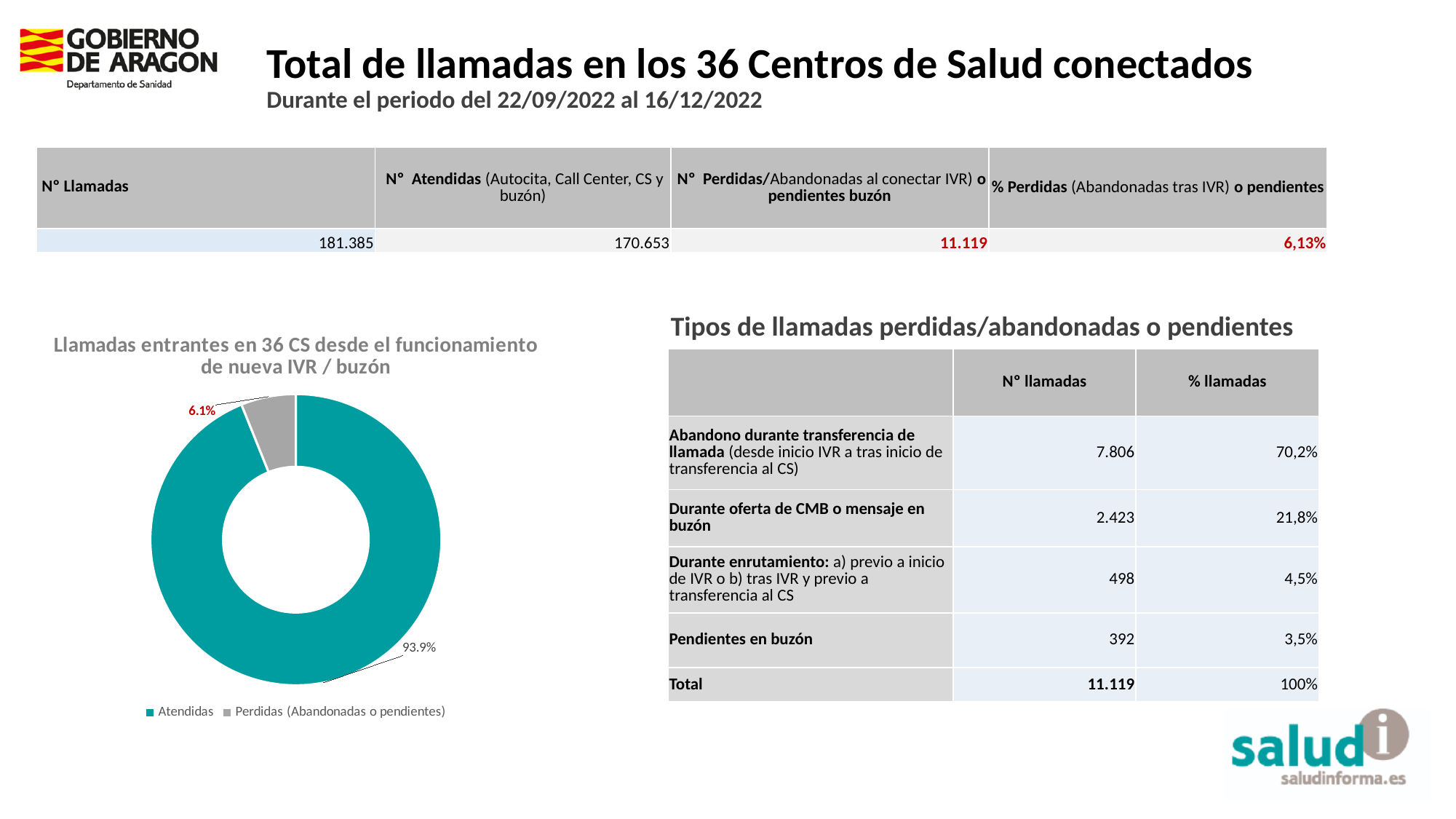
Which is larger in the chart, Atendidas or Perdidas (Abandonadas o pendientes)? Atendidas Which category has the largest slice in the chart? Atendidas What colour is the Atendidas slice in the chart? teal How many slices does the chart have? 2 What share of the chart does the Atendidas slice represent? 93.9% What share of the chart does the Perdidas (Abandonadas o pendientes) slice represent? 6.1% How many entries does the chart's legend list? 2 What is the title of the chart on the slide? Llamadas entrantes en 36 CS desde el funcionamiento de nueva IVR / buzón What kind of chart is shown on the slide? doughnut chart What is the difference in percentage points between the Atendidas slice and the Perdidas (Abandonadas o pendientes) slice? 87.8% Which category has the smallest slice in the chart? Perdidas (Abandonadas o pendientes)